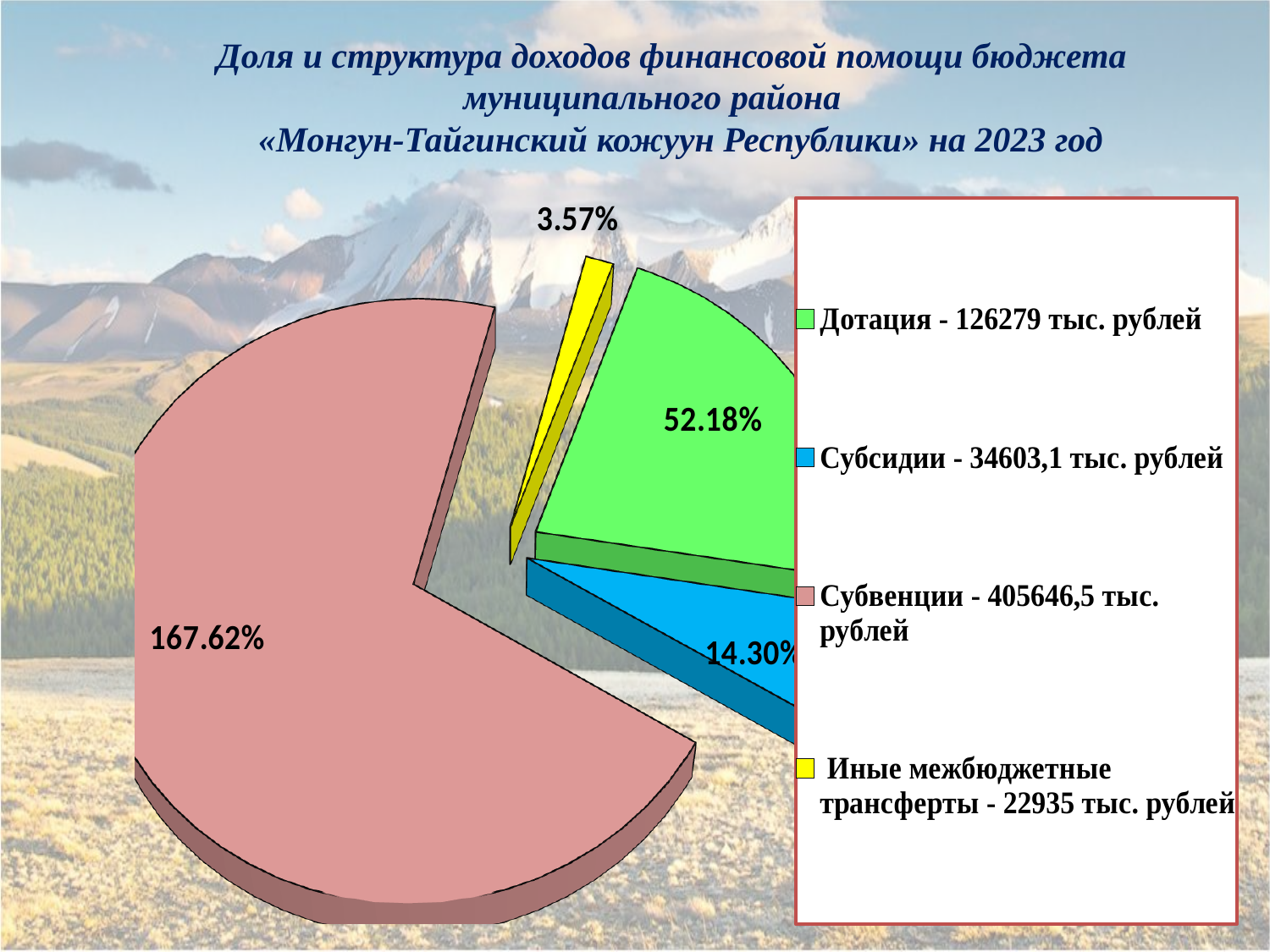
What percentage is shown for the Субвенции slice? 167.62% How many slices does the pie chart have? 4 How many entries does the legend list? 4 What kind of chart is shown on the slide? pie chart What percentage is shown for the Дотация slice? 52.18% Which category has the smallest slice of the pie? Иные межбюджетные трансферты Which slice is larger, Дотация or Субсидии? Дотация What percentage is shown for the Иные межбюджетные трансферты slice? 3.57% What is the difference between the percentages shown for Дотация and Субсидии? 37.88% Which category has the largest slice of the pie? Субвенции What amount does the legend give for Субсидии? 34603,1 тыс. рублей What percentage is shown for the Субсидии slice? 14.30%